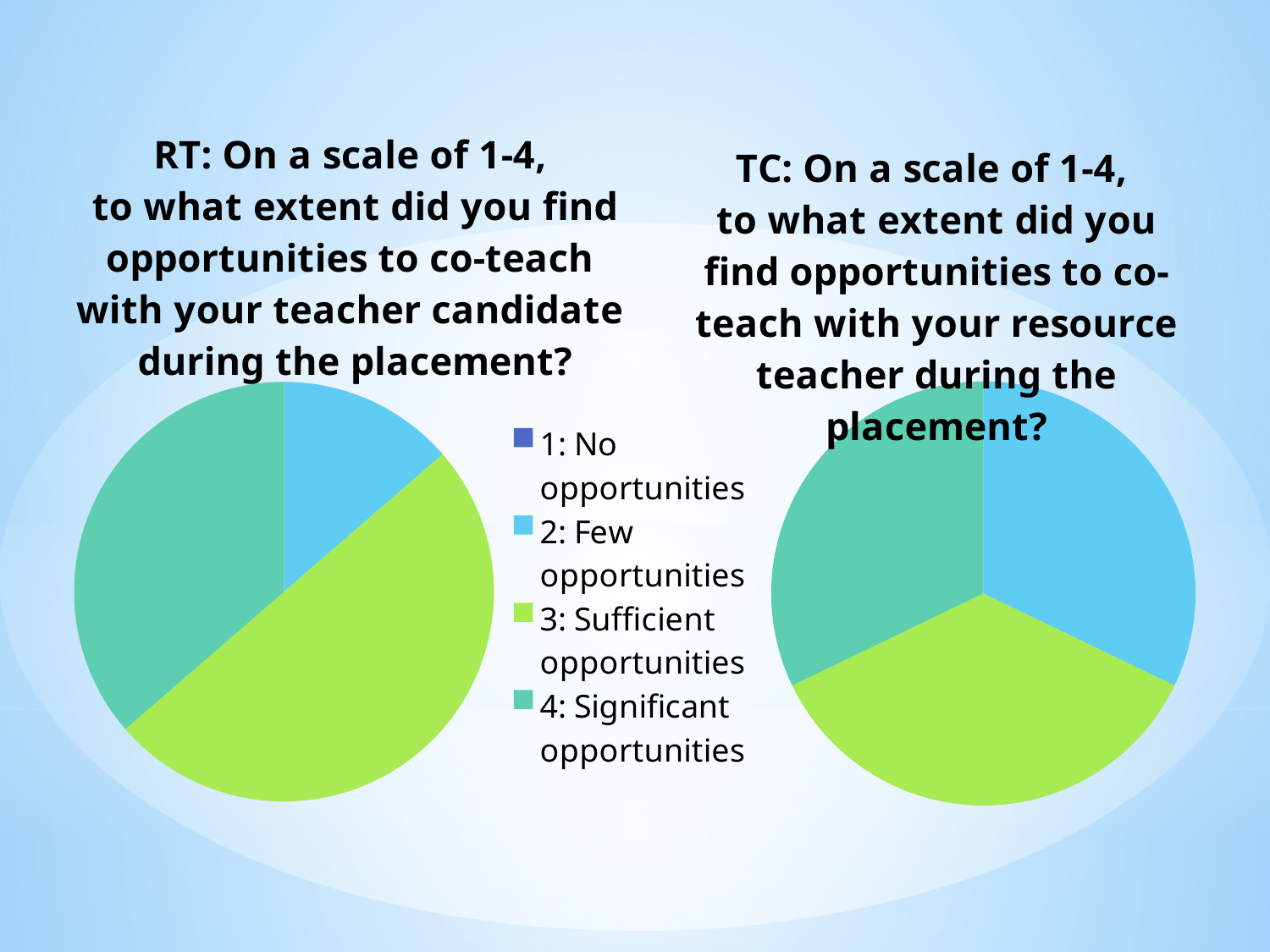
What colour represents 3: Sufficient opportunities in the legend? Green In the left chart (RT), which slice is larger: 3: Sufficient opportunities or 2: Few opportunities? 3: Sufficient opportunities In the left chart (RT), which category has the largest slice? 3: Sufficient opportunities Which legend category does not appear as a visible slice in either pie chart? 1: No opportunities How many slices are visible in the right chart (TC)? 3 In the left chart (RT), which of the visible slices is the smallest? 2: Few opportunities What kind of chart is the left chart (RT) on the slide? Pie chart How many categories does the legend list? 4 How many slices are visible in the left chart (RT)? 3 What kind of chart is the right chart (TC) on the slide? Pie chart In the left chart (RT), which slice is larger: 4: Significant opportunities or 2: Few opportunities? 4: Significant opportunities